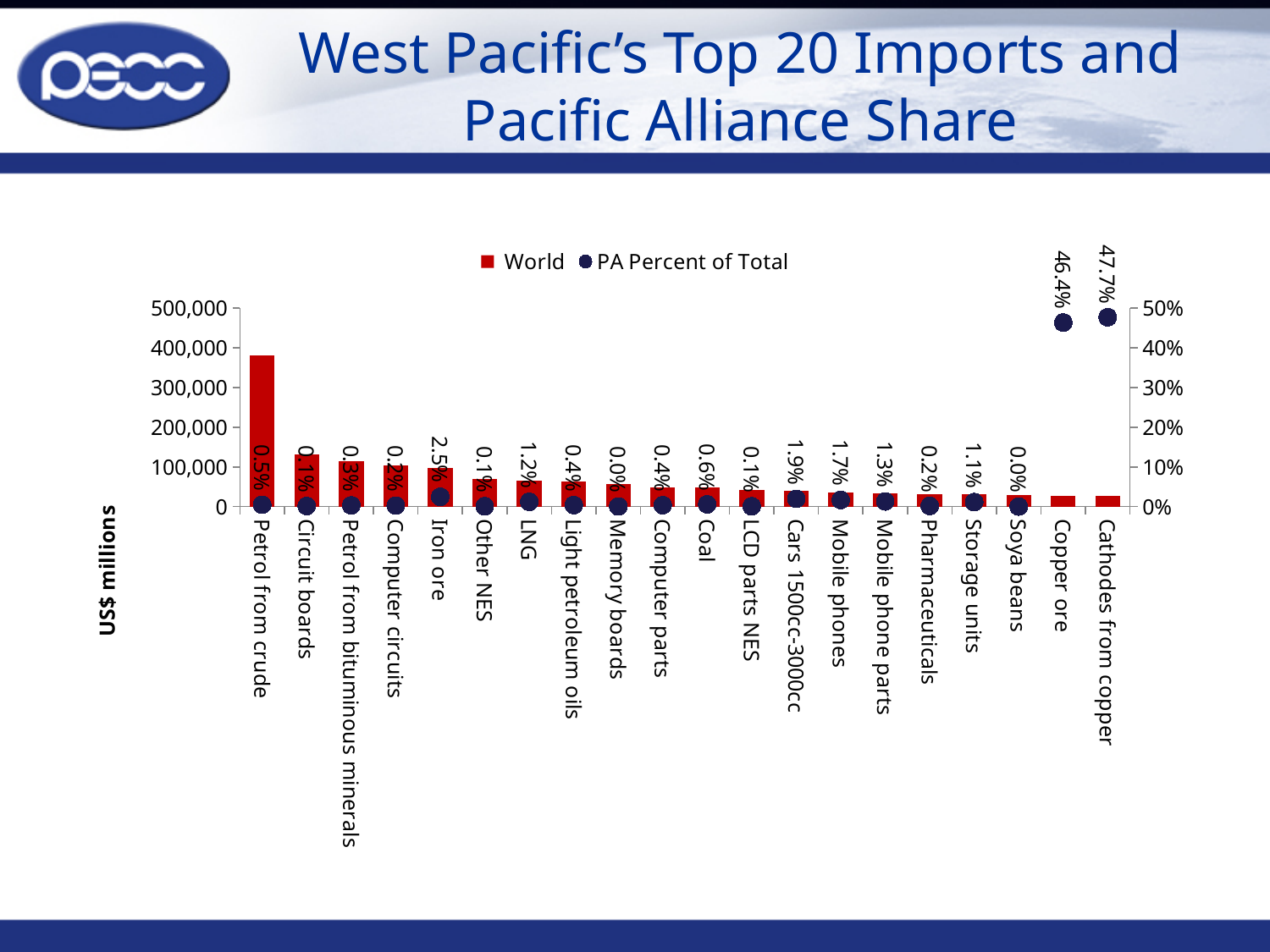
Do the World import values generally rise or fall from left to right along the x axis? fall What is the PA Percent of Total for Petrol from crude? 0.5% Which import category has the highest PA Percent of Total? Cathodes from copper What is the difference in PA Percent of Total between Cathodes from copper and Copper ore? 1.3 percentage points Which has a higher PA Percent of Total, Iron ore or LNG? Iron ore What kind of chart is used to plot the World series? bar chart What is the PA Percent of Total for Cathodes from copper? 47.7% Is the World import value for Petrol from crude greater or less than 300,000? greater How many import categories are shown on the x axis? 20 How many series does the legend list? 2 What is the PA Percent of Total for Cars 1500cc-3000cc? 1.9% What is the PA Percent of Total for Iron ore? 2.5%